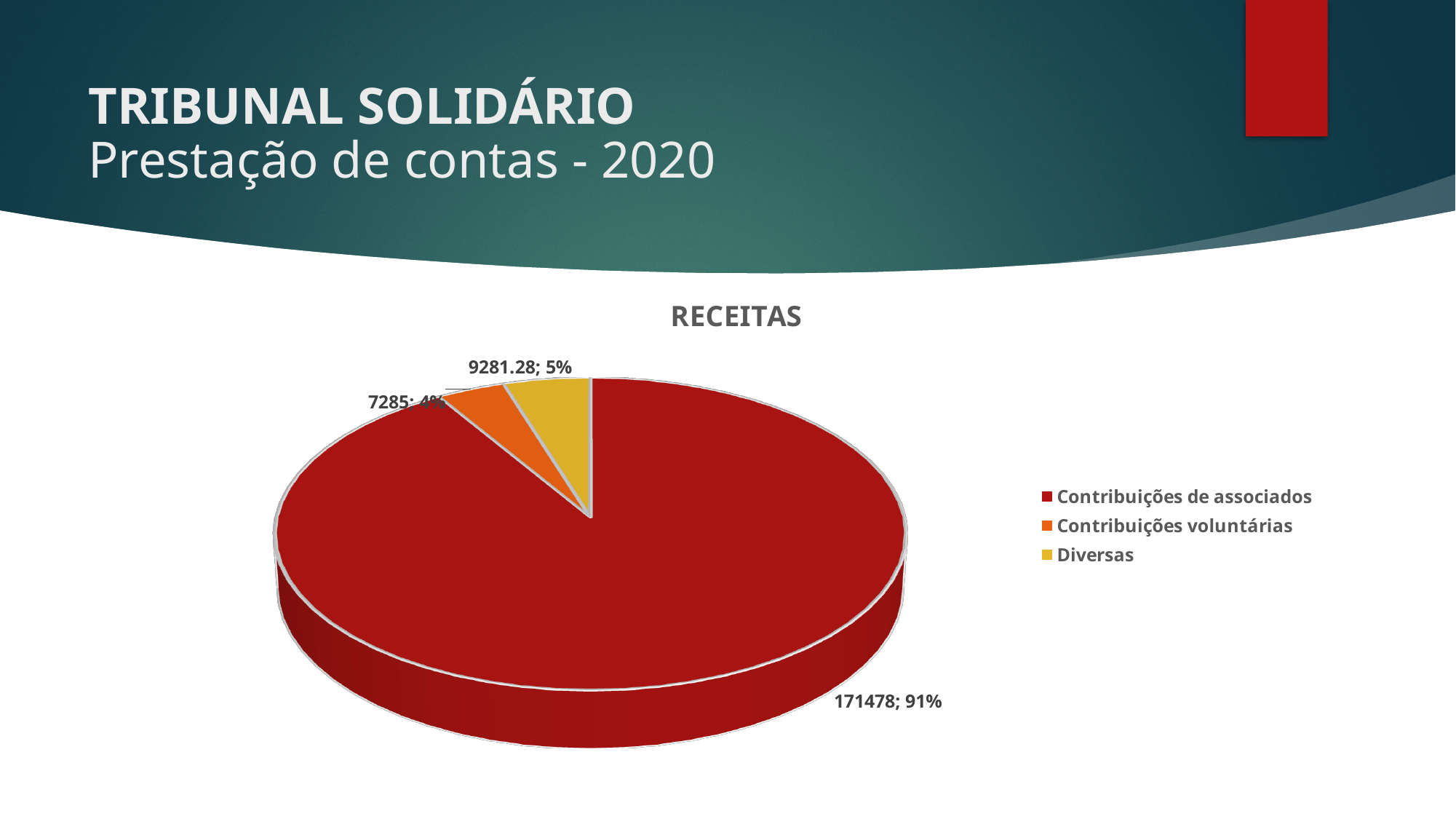
What share of the pie does Contribuições voluntárias represent? 4% What is the value for Contribuições de associados? 171478 Which is larger, Diversas or Contribuições voluntárias? Diversas Which category has the largest slice? Contribuições de associados What share of the pie does Diversas represent? 5% Which category has the smallest slice? Contribuições voluntárias What is the value for Diversas? 9281.28 What is the title of the chart? RECEITAS How many categories does the pie chart show? 3 What share of the pie does Contribuições de associados represent? 91% What is the difference between the values for Contribuições de associados and Contribuições voluntárias? 164193 What is the value for Contribuições voluntárias? 7285